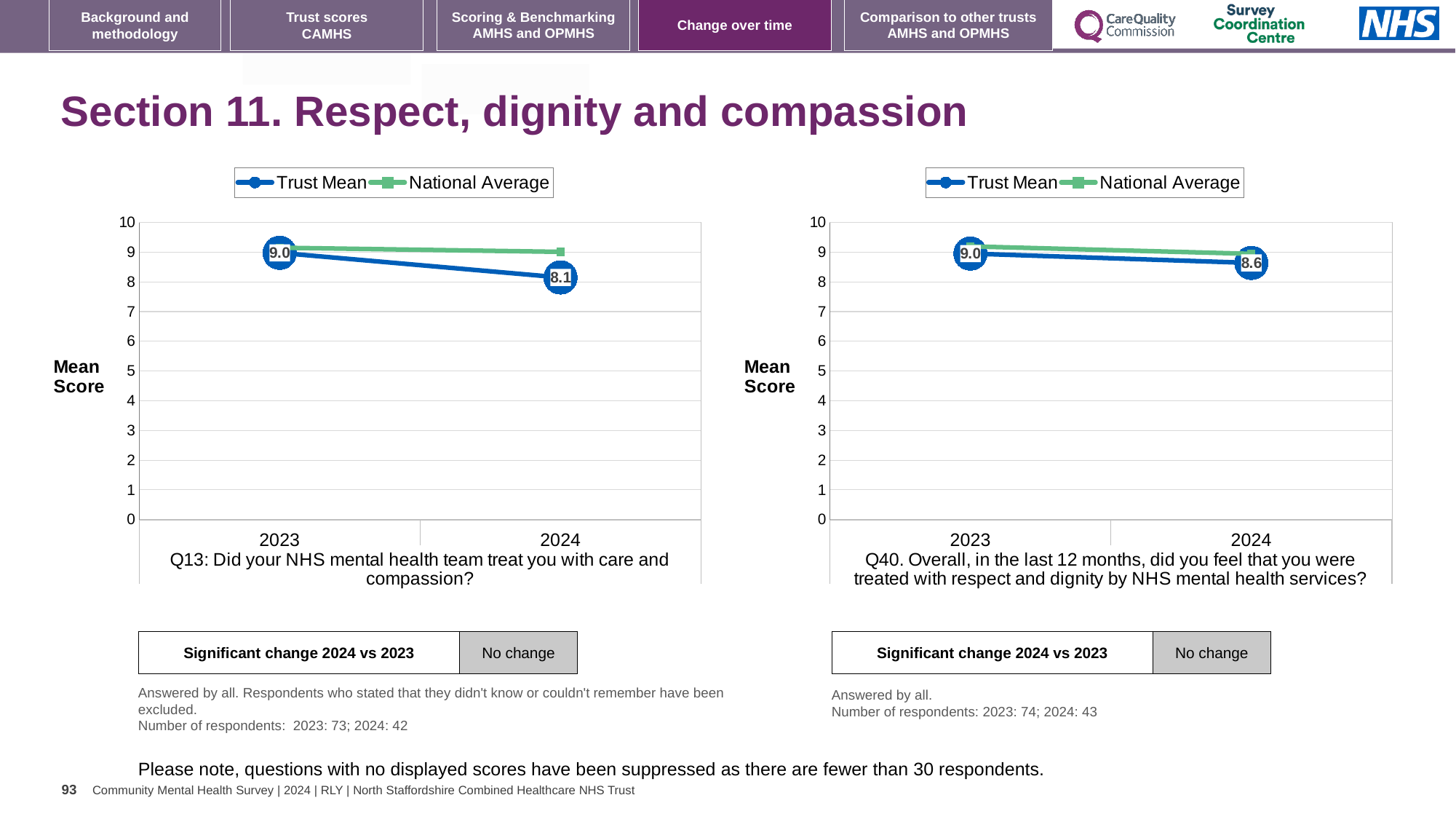
In the Q13 chart on the left, what is the Trust Mean score for 2024? 8.1 In the Q40 chart on the right, what is the Trust Mean score for 2024? 8.6 In the Q40 chart on the right, what is the Trust Mean score for 2023? 9.0 What kind of chart is the Q40 chart on the right? line chart In the Q13 chart on the left, is the National Average value for 2024 greater or less than 8? greater In the Q13 chart on the left, by how much did the Trust Mean fall from 2023 to 2024? 0.9 In the Q13 chart on the left, what is the Trust Mean score for 2023? 9.0 In the Q13 chart on the left, which series has the higher value in 2024, Trust Mean or National Average? National Average How many series does the legend of the Q40 chart on the right list? 2 How many years are plotted on the x axis of the Q13 chart on the left? 2 In the Q40 chart on the right, what is the difference between the Trust Mean in 2023 and in 2024? 0.4 In the Q13 chart on the left, does the Trust Mean rise or fall from 2023 to 2024? fall